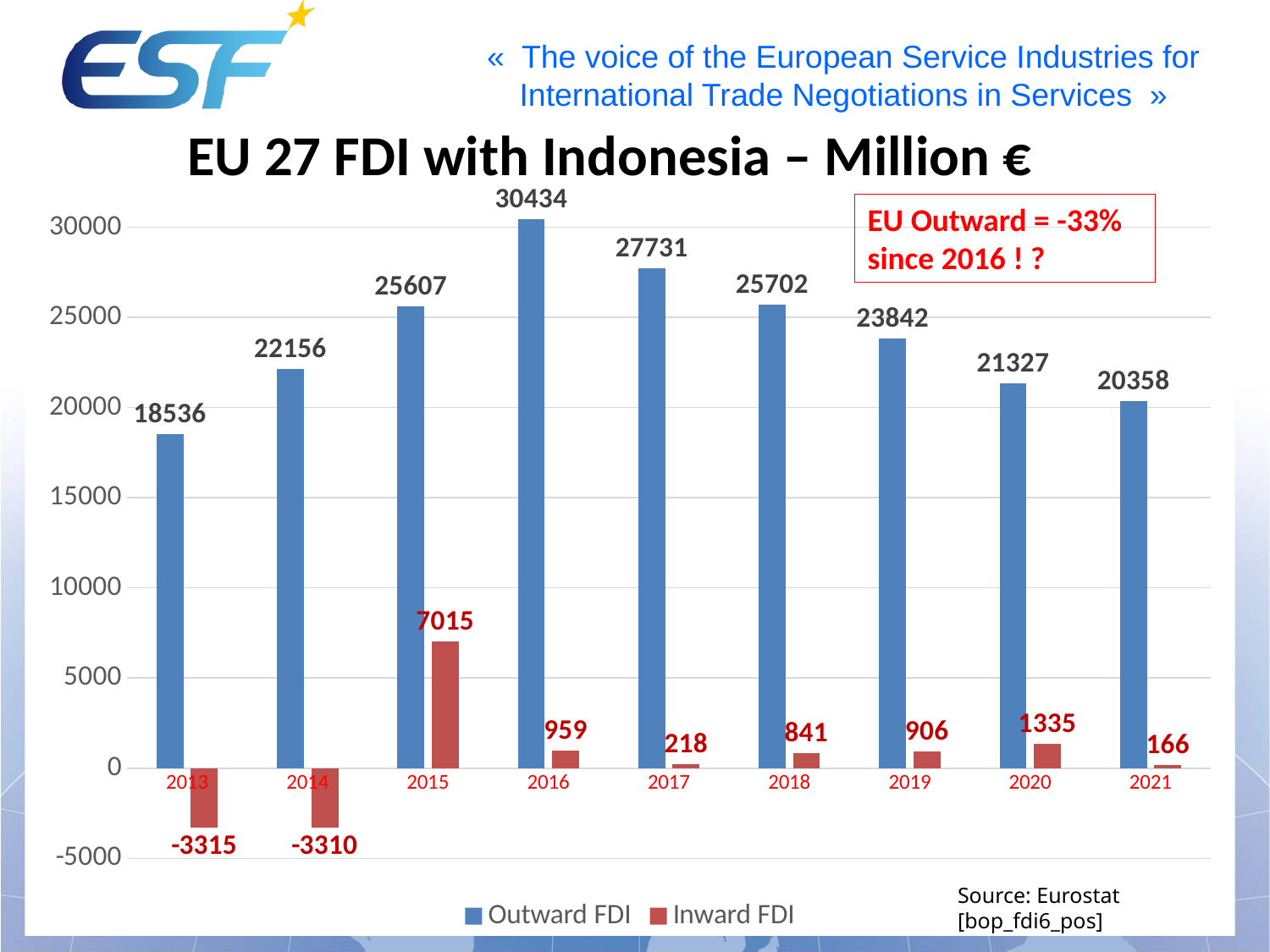
What is the difference between Outward FDI in 2016 and in 2021? 10076 What is the Inward FDI value for 2013? -3315 What is the Outward FDI value for 2016? 30434 How many series does the legend list? 2 Which is larger, Inward FDI in 2019 or Inward FDI in 2020? 2020 What is the Inward FDI value for 2015? 7015 Which year has the highest Outward FDI? 2016 How many years are shown on the x axis? 9 Which year has the lowest Outward FDI? 2013 Does Outward FDI rise or fall from 2016 to 2021? Fall What is the title of the chart? EU 27 FDI with Indonesia – Million € What kind of chart is shown on the slide? Bar chart